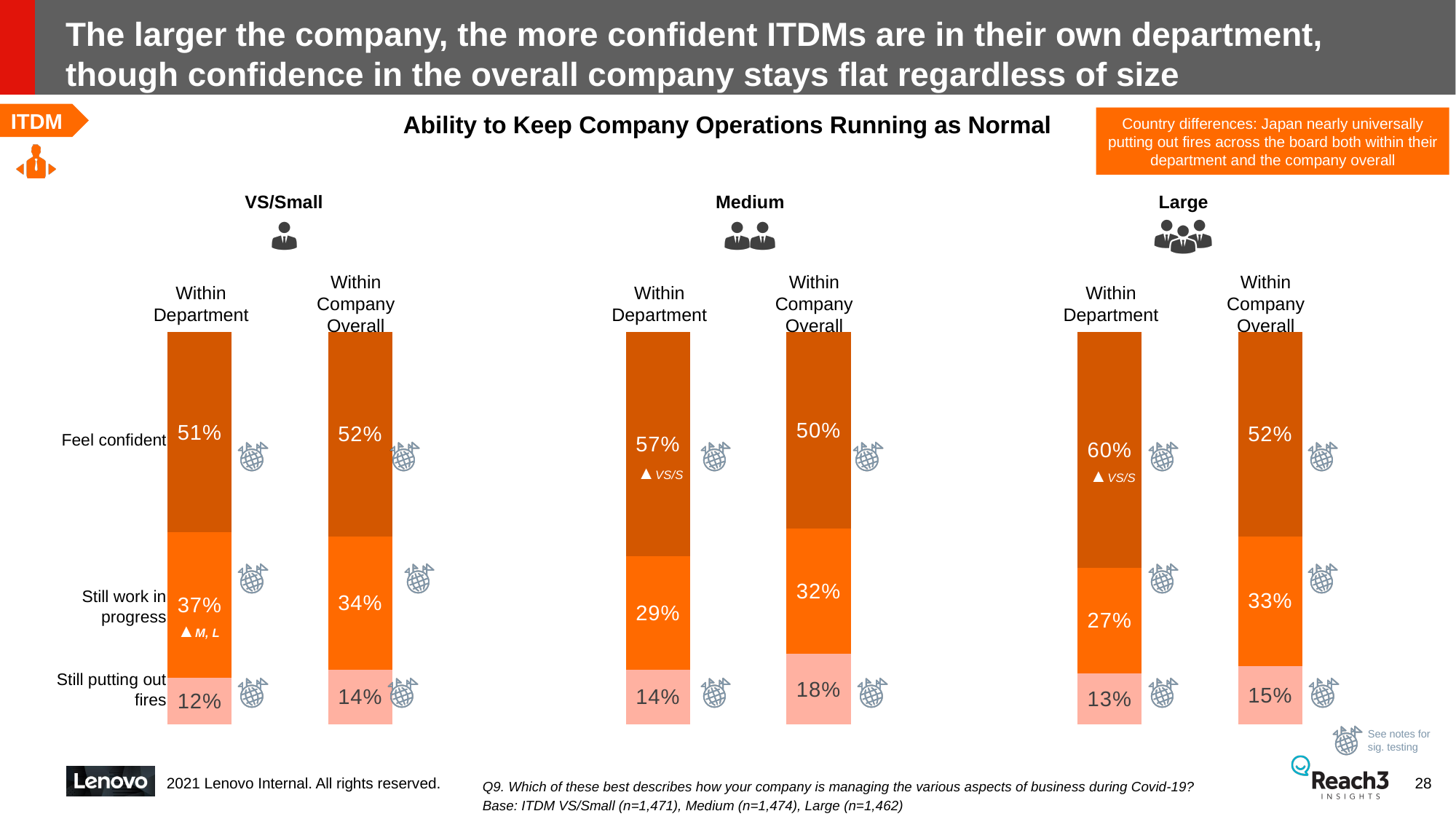
What is the title shown above the three charts? Ability to Keep Company Operations Running as Normal In the VS/Small chart, what is the total of the three segments in the Within Department bar? 100% In the VS/Small chart, what percentage of ITDMs feel confident within their department? 51% In the Large chart, what percentage of ITDMs feel confident within their department? 60% In the VS/Small chart, which segment of the Within Department bar is the smallest? Still putting out fires In the Large chart, which is larger: 'Still work in progress' for Within Department or for Within Company Overall? Within Company Overall What kind of chart is used to show the Ability to Keep Company Operations Running as Normal data? Stacked bar chart In the Medium chart, what is the difference between the 'Feel confident' values for Within Department and Within Company Overall? 7% In the Medium chart, what percentage are still putting out fires within the company overall? 18% How many bars are shown in the Medium chart? 2 Across the three charts, which company size has the highest 'Feel confident' value for Within Department? Large In the Large chart, what percentage say work is still in progress within the company overall? 33%